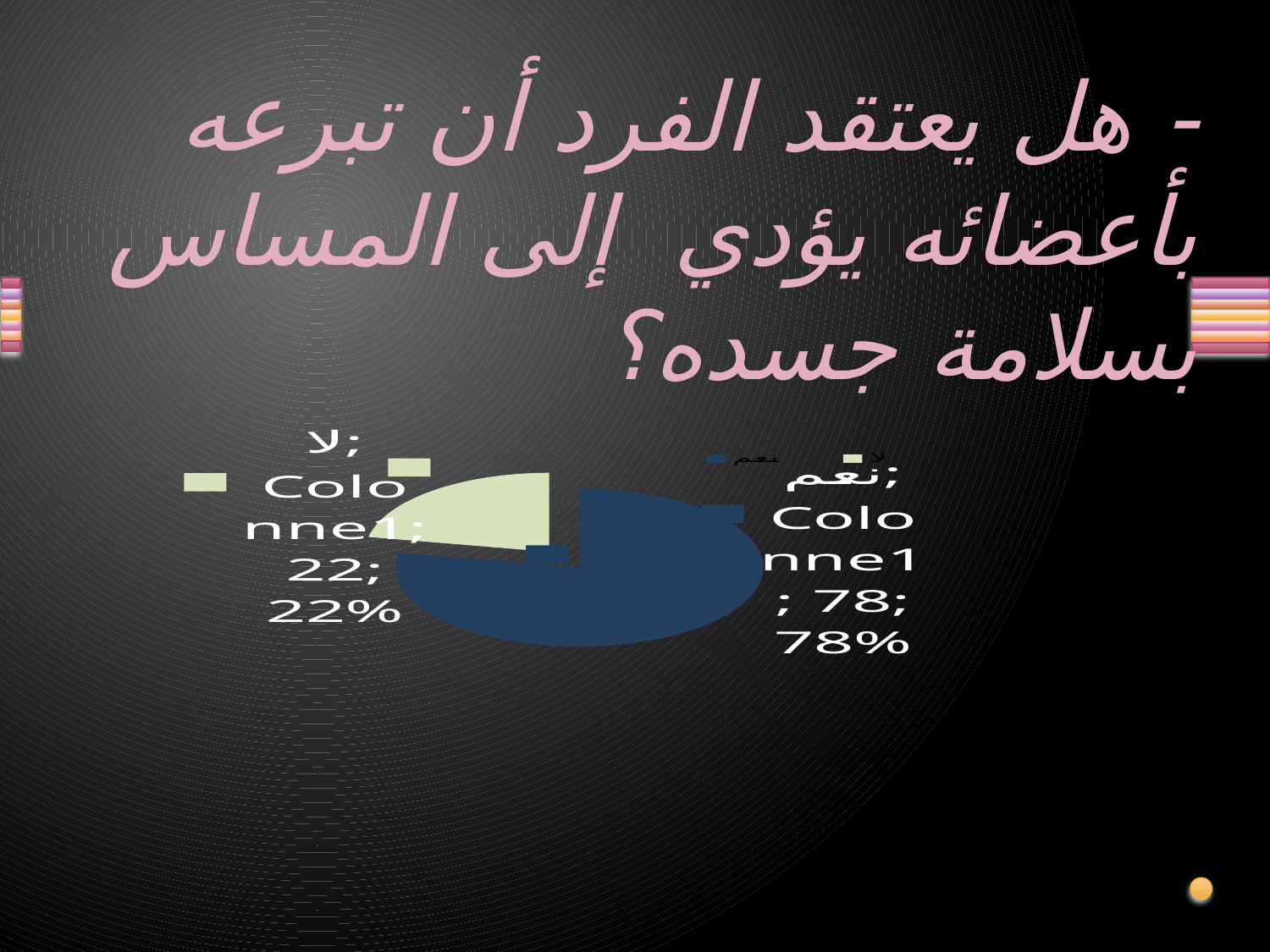
What percentage share of the pie does the "نعم" slice have? 78% What kind of chart is shown on the slide? pie chart How many slices does the pie chart have? 2 What percentage share of the pie does the "لا" slice have? 22% What is the total of the two slice values in the pie chart? 100 What value is shown for the "لا" slice of the pie chart? 22 What value is shown for the "نعم" slice of the pie chart? 78 What is the difference between the values of the "نعم" and "لا" slices? 56 Which is larger, the "نعم" slice or the "لا" slice? نعم Which slice of the pie chart is the smallest? لا Which slice of the pie chart is the largest? نعم What colour is the "نعم" slice of the pie chart? dark blue